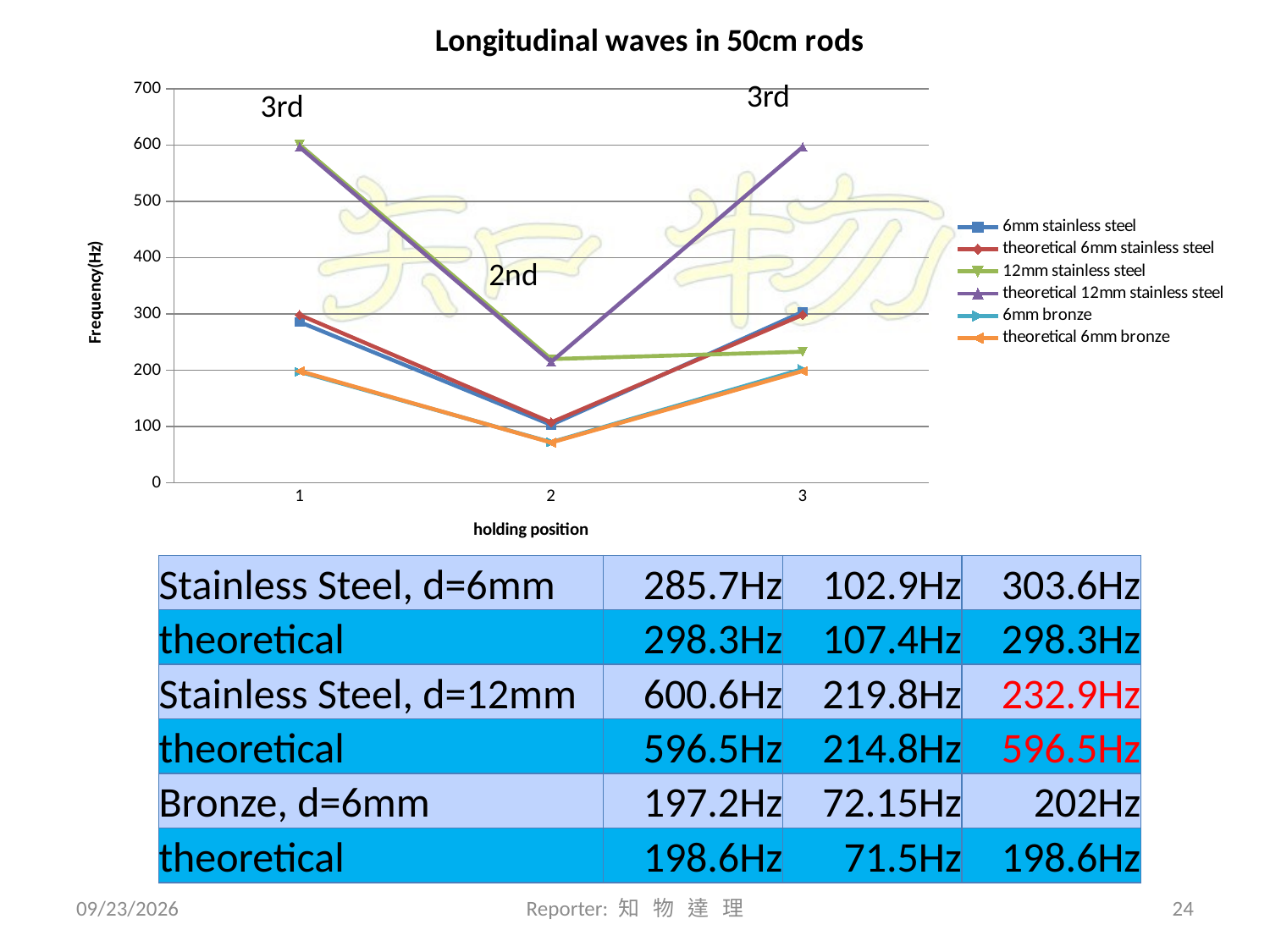
Does the 12mm stainless steel series rise or fall from holding position 1 to holding position 2? fall What is the label of the y axis? Frequency(Hz) According to the table, what is the measured frequency for Stainless Steel, d=6mm at holding position 1? 285.7Hz At holding position 3, which is larger: 12mm stainless steel or theoretical 12mm stainless steel? theoretical 12mm stainless steel At which holding position is the 6mm stainless steel series lowest? 2 How many holding positions are plotted along the x axis? 3 Is the value for 6mm bronze at holding position 2 greater or less than 100? less What kind of chart is shown on the slide? line chart How many series does the chart legend list? 6 Which series has the highest value at holding position 3? theoretical 12mm stainless steel What is the title of the chart? Longitudinal waves in 50cm rods Is the value for theoretical 12mm stainless steel at holding position 3 greater or less than 500? greater